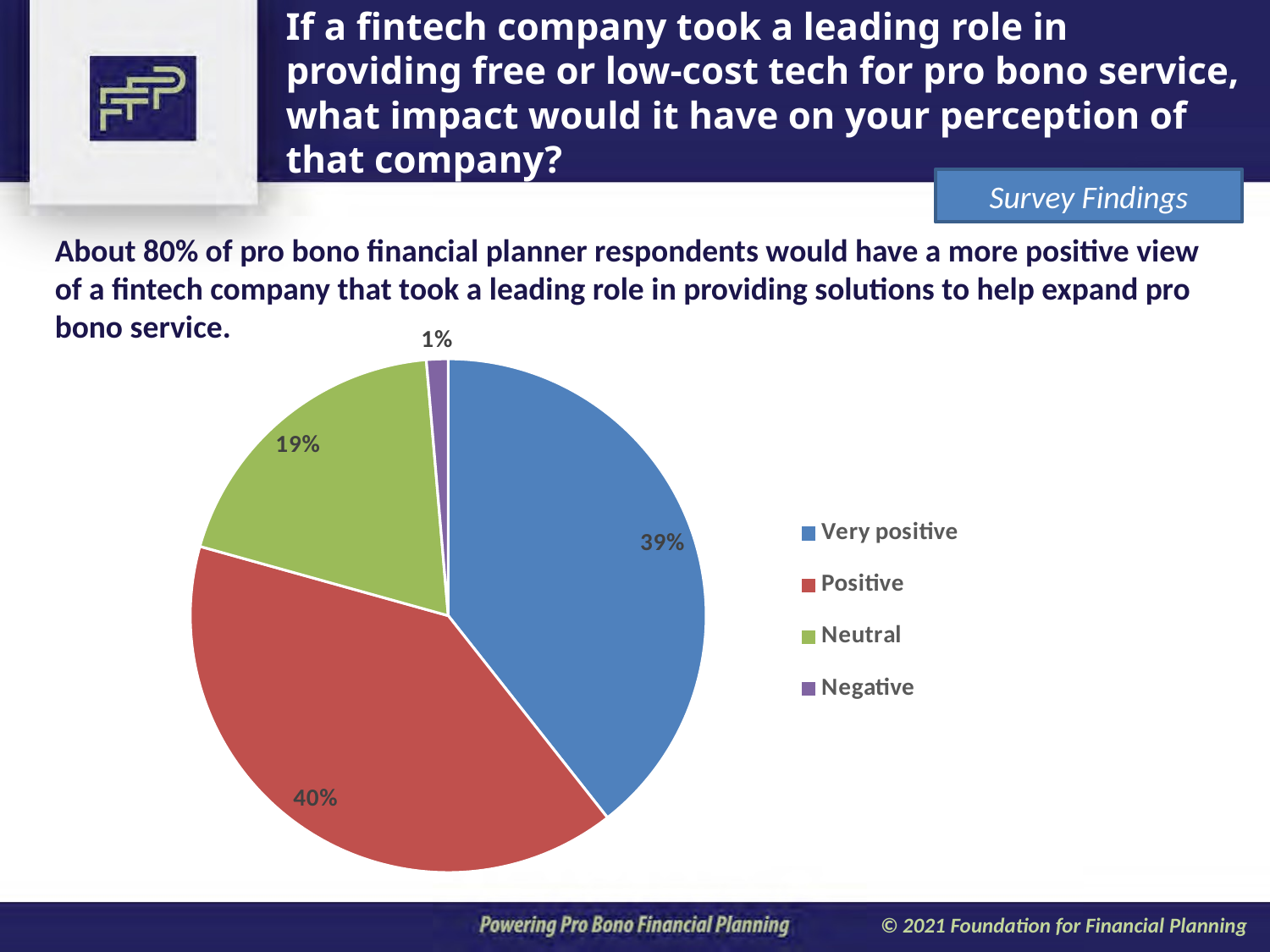
What share of respondents answered "Very positive"? 39% How many categories does the pie chart show? 4 What share of respondents answered "Neutral"? 19% How many entries does the legend list? 4 What colour is the "Neutral" slice in the pie chart? Green What is the combined share of the "Very positive" and "Positive" slices? 79% What kind of chart is shown on the slide? Pie chart Which is larger, the "Neutral" slice or the "Negative" slice? Neutral What share of respondents answered "Negative"? 1% Which response category has the smallest slice of the pie? Negative What share of respondents answered "Positive"? 40% What is the difference in percentage points between the "Positive" and "Neutral" slices? 21